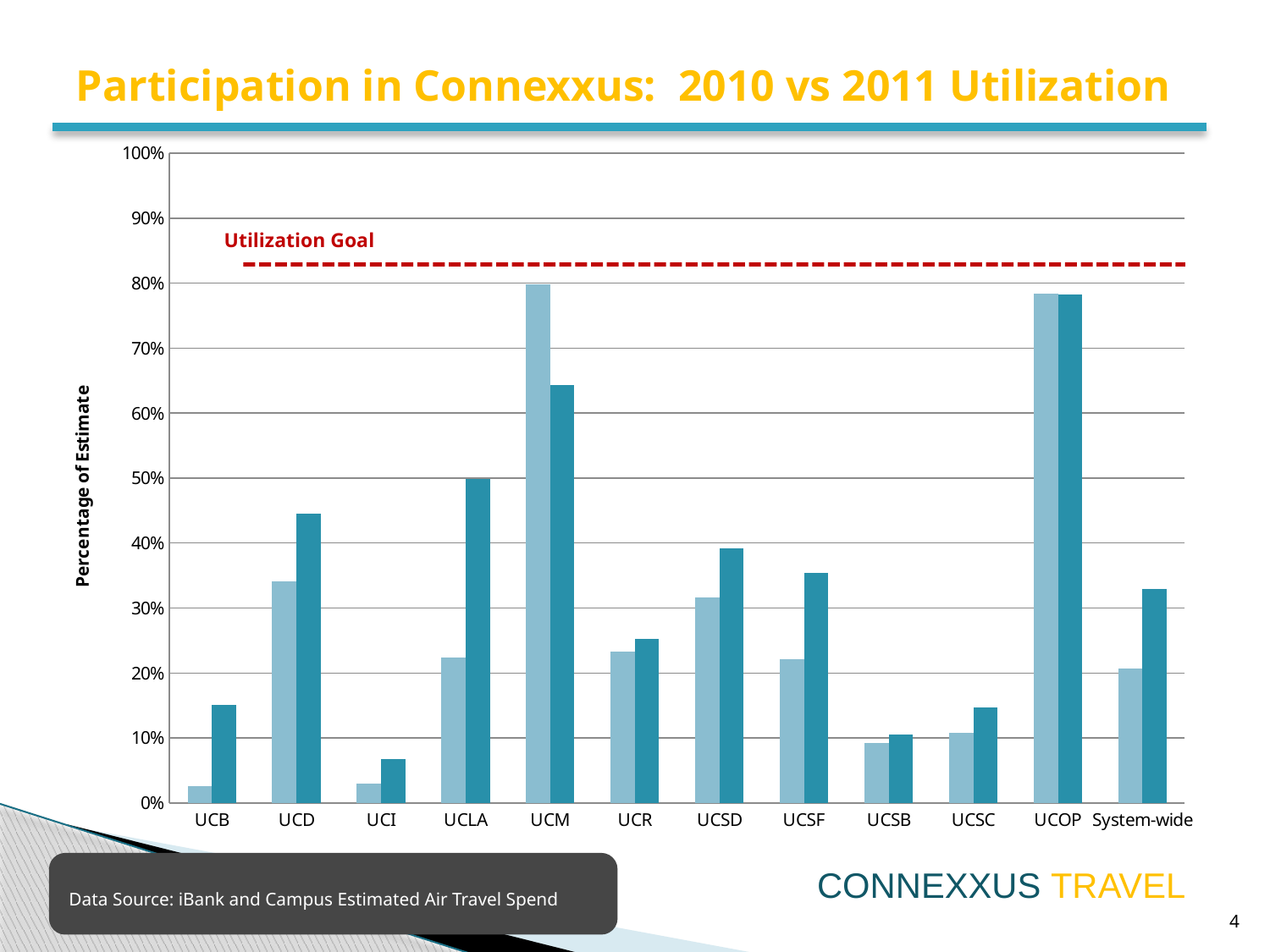
Is the darker blue bar for UCB greater or less than 10%? greater What type of chart is shown on the slide? bar chart For UCM, which bar is larger, the lighter blue bar or the darker blue bar? the lighter blue bar What is the title of the chart's y axis? Percentage of Estimate Is the darker blue bar for System-wide greater or less than 30%? greater Is the lighter blue bar for UCI greater or less than 10%? less How many categories are shown along the x axis of the chart? 12 What label is given to the red dashed horizontal line on the chart? Utilization Goal Which category has the highest darker blue bar? UCOP For UCD, which bar is larger, the lighter blue bar or the darker blue bar? the darker blue bar